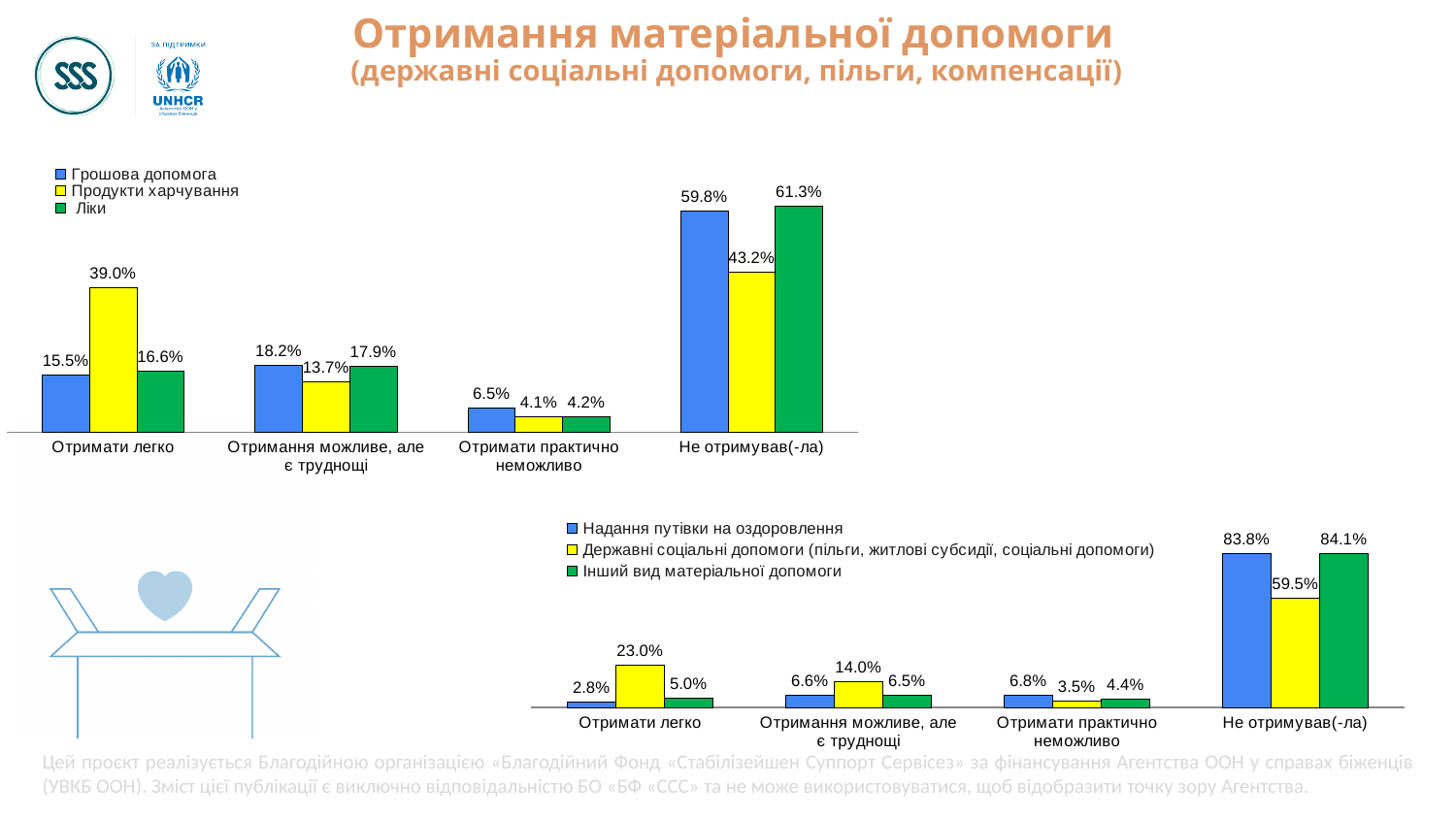
In the top chart, which series has the highest value in the category Не отримував(-ла)? Ліки In the top chart, what is the value for Продукти харчування in the category Отримати легко? 39.0% In the bottom chart, which is larger in the category Отримання можливе, але є труднощі: Надання путівки на оздоровлення or Державні соціальні допомоги? Державні соціальні допомоги In the bottom chart, what is the value for Державні соціальні допомоги (пільги, житлові субсидії, соціальні допомоги) in the category Отримати легко? 23.0% In the top chart, what is the difference between Грошова допомога and Продукти харчування in the category Отримати легко? 23.5% In the bottom chart, which series has the lowest value in the category Отримати легко? Надання путівки на оздоровлення What kind of chart is the bottom chart? Bar chart In the top chart, what is the value for Грошова допомога in the category Не отримував(-ла)? 59.8% In the top chart, how many series does the legend list? 3 In the bottom chart, what is the value for Інший вид матеріальної допомоги in the category Не отримував(-ла)? 84.1% In the top chart, how many categories are shown on the x axis? 4 In the bottom chart, what is the difference between Надання путівки на оздоровлення and Державні соціальні допомоги in the category Не отримував(-ла)? 24.3%